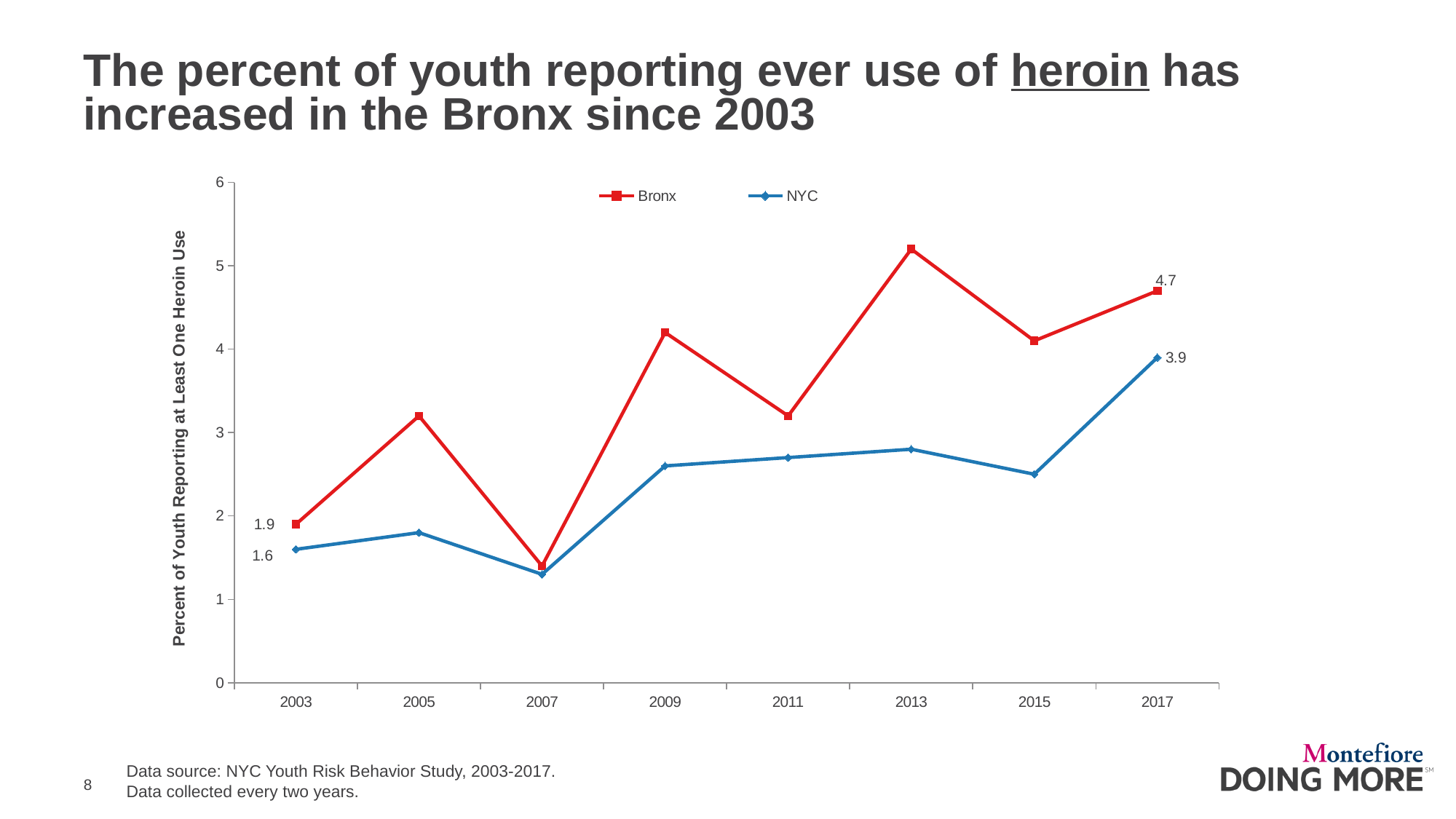
How many series does the legend list? 2 What is the Bronx value in 2003? 1.9 What is the NYC value in 2017? 3.9 How many years are shown on the x axis? 8 In which year is the Bronx value highest? 2013 What is the NYC value in 2003? 1.6 What kind of chart is shown on the slide? line chart Is the Bronx value in 2013 greater or less than 5? greater In which year is the NYC value lowest? 2007 By how much did the Bronx value increase from 2003 to 2017? 2.8 What is the Bronx value in 2017? 4.7 What is the difference between the Bronx and NYC values in 2017? 0.8